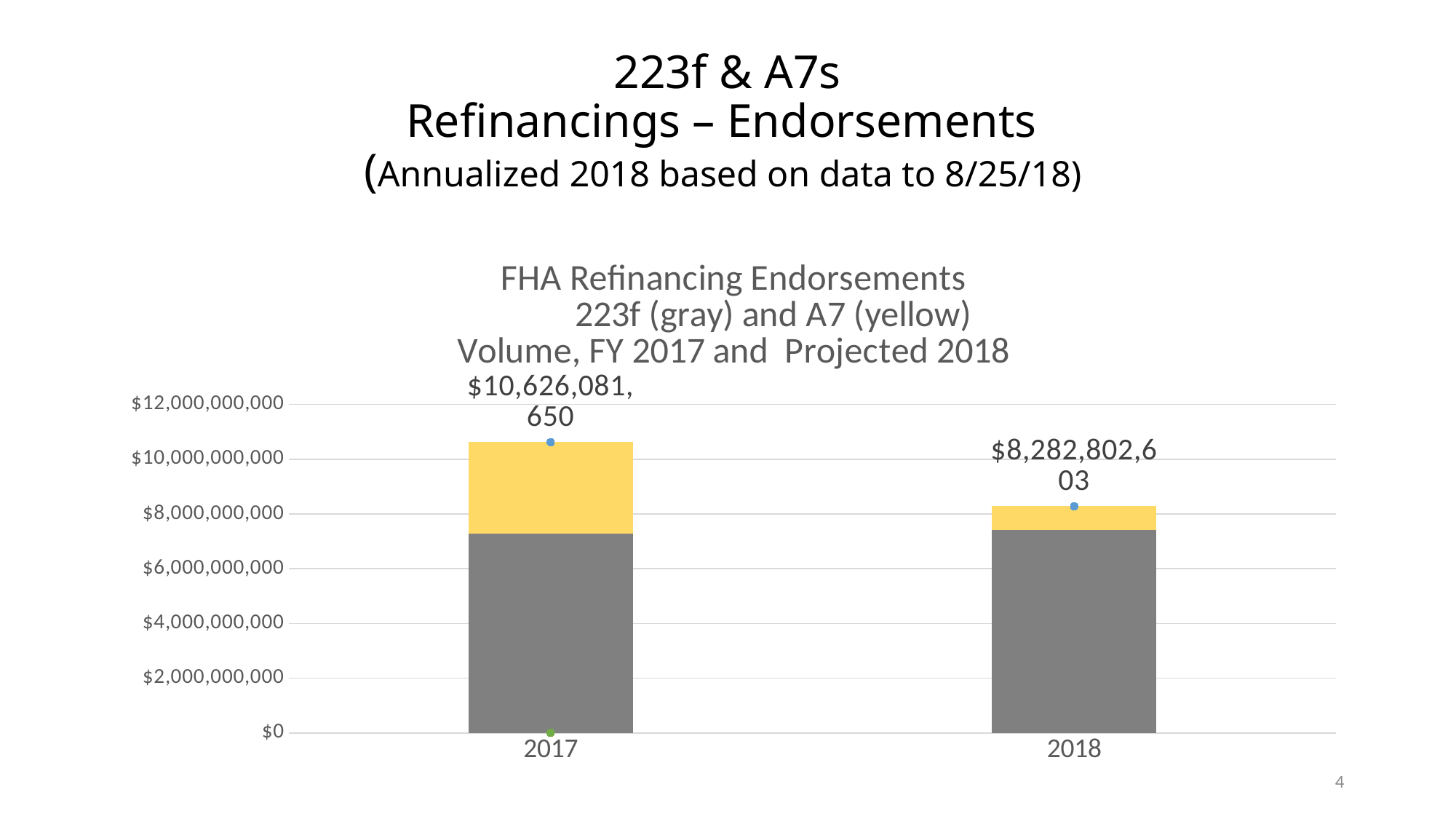
Which colour represents 223f in the chart? Gray Is the A7 (yellow) volume for 2018 greater or less than $2,000,000,000? less What is the total projected FHA refinancing endorsement volume shown for 2018? $8,282,802,603 Which year has the lower total endorsement volume? 2018 What is the total FHA refinancing endorsement volume shown for 2017? $10,626,081,650 What kind of chart is shown on the slide? Stacked bar chart What is the difference between the 2017 total and the 2018 total? $2,343,279,047 Is the 223f (gray) volume for 2017 greater or less than $8,000,000,000? less Does the total endorsement volume rise or fall from 2017 to 2018? Fall Which year has the higher total endorsement volume? 2017 How many years (categories) are plotted on the x axis? 2 Is the A7 (yellow) segment larger in 2017 or in 2018? 2017